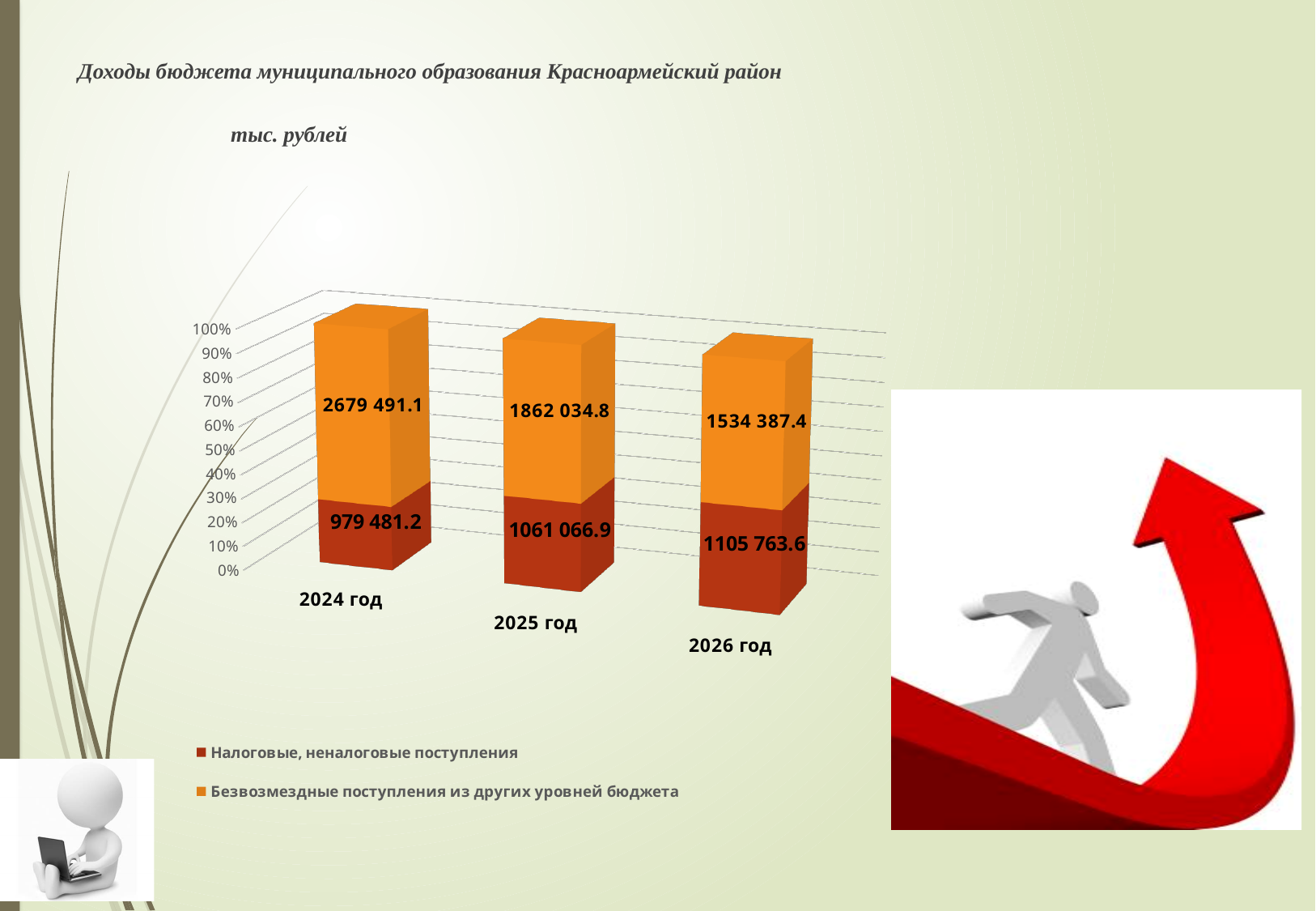
What is the difference between Безвозмездные поступления из других уровней бюджета and Налоговые, неналоговые поступления in 2026 год? 428 623.8 How many years are shown on the x axis? 3 In which year is the value for Безвозмездные поступления из других уровней бюджета the highest? 2024 год What is the value for Безвозмездные поступления из других уровней бюджета in 2026 год? 1534 387.4 How many series does the legend list? 2 What is the value for Налоговые, неналоговые поступления in 2024 год? 979 481.2 In which year is the value for Налоговые, неналоговые поступления the lowest? 2024 год What is the value for Безвозмездные поступления из других уровней бюджета in 2025 год? 1862 034.8 Which is larger in 2025 год: Налоговые, неналоговые поступления or Безвозмездные поступления из других уровней бюджета? Безвозмездные поступления из других уровней бюджета Do the values for Налоговые, неналоговые поступления rise or fall from 2024 год to 2026 год? Rise What is the value for Налоговые, неналоговые поступления in 2026 год? 1105 763.6 What kind of chart is shown on the slide? Stacked bar chart